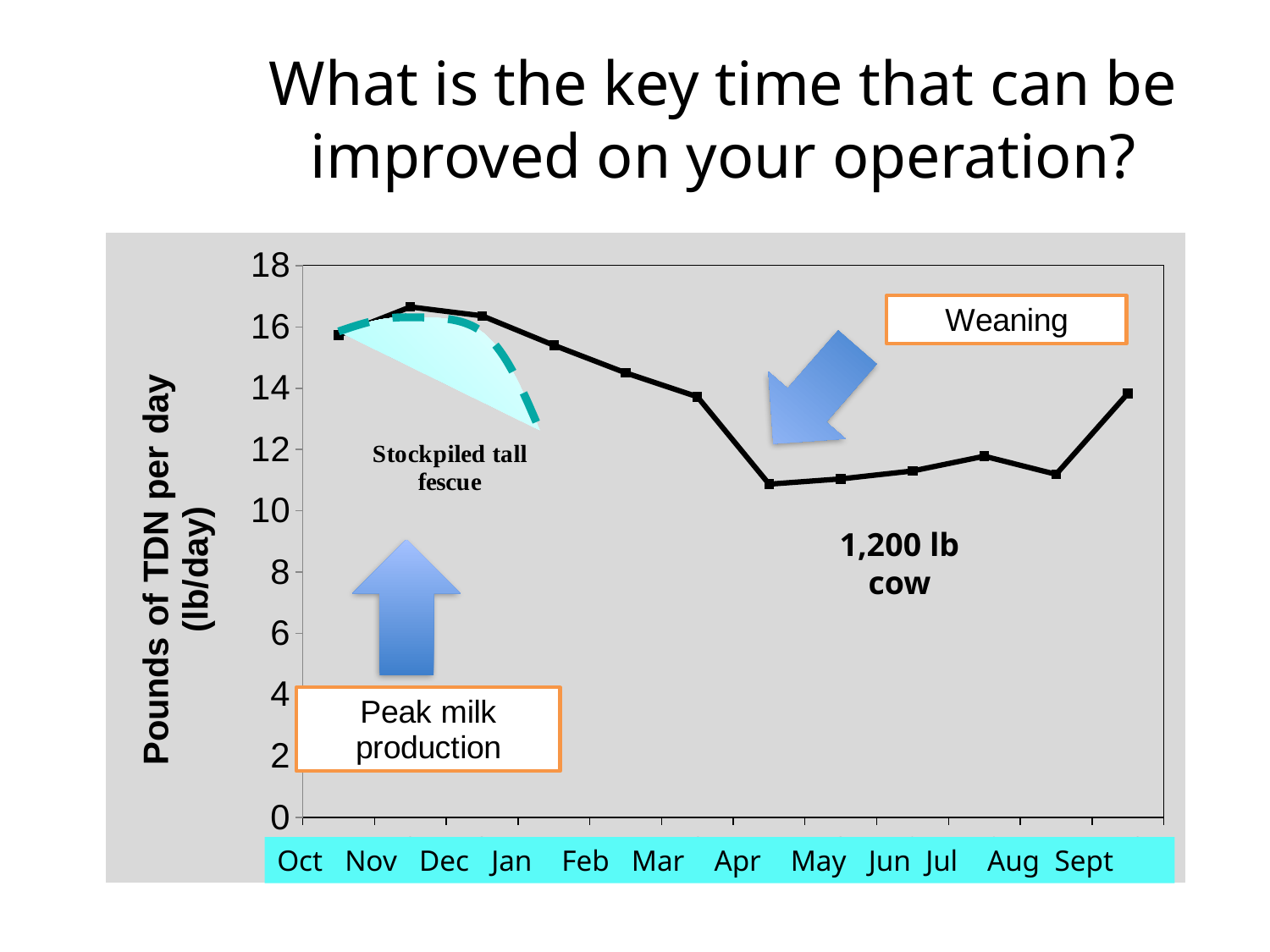
How many months are plotted along the x axis of the chart? 12 What label is in the box that the arrow near Apr points to? Weaning Is the value for Mar greater or less than 16? less Which month has the highest value on the chart? Nov Do the values rise or fall from Nov to Apr? fall Is the value for Oct greater or less than 14? greater Is the value for Apr greater or less than 12? less What kind of chart is shown on the slide? line chart What is the label on the y axis of the chart? Pounds of TDN per day (lb/day) Which is larger, the value for Jan or the value for Jul? Jan Which is larger, the value for Nov or the value for Mar? Nov